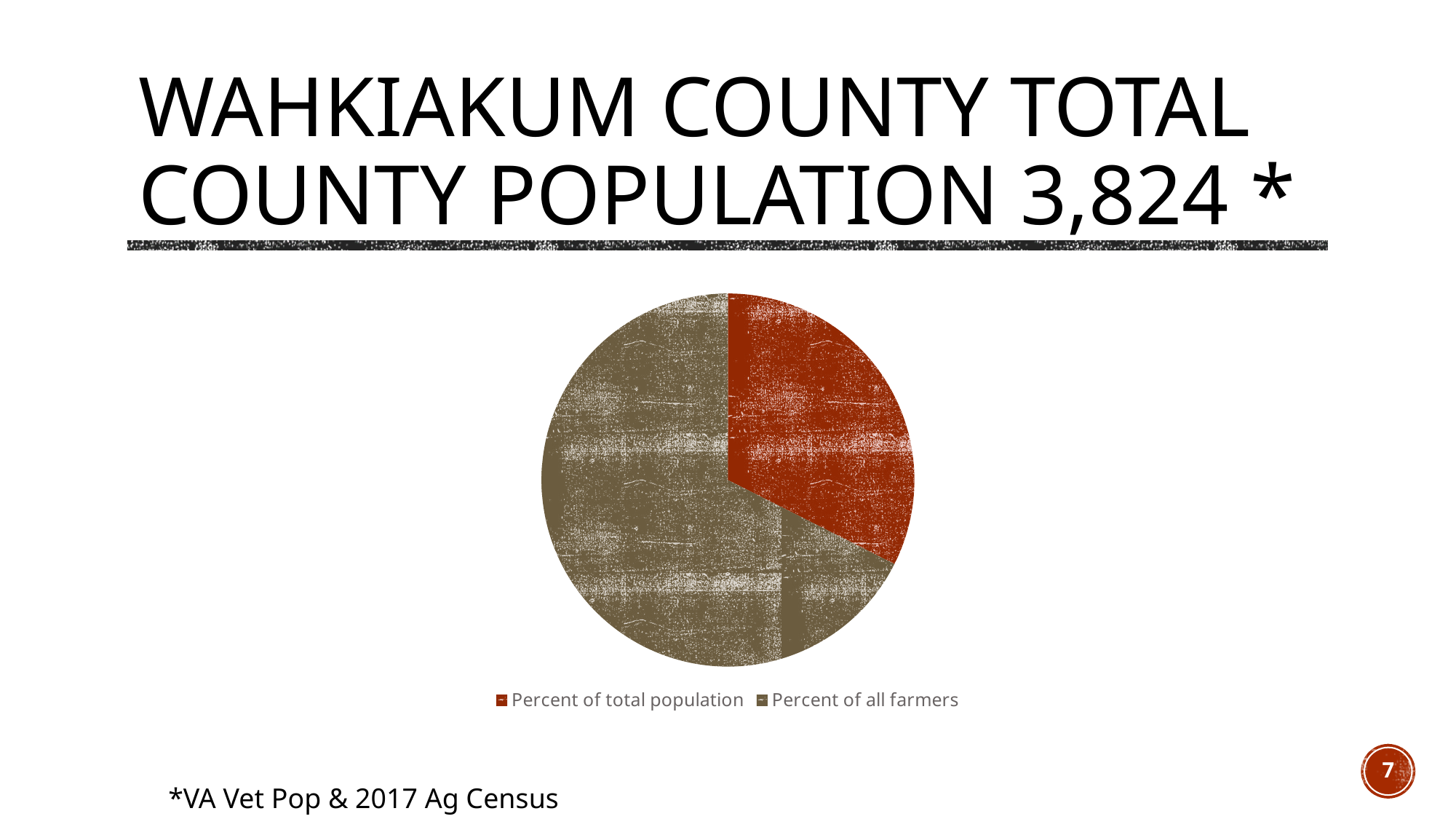
Which slice is larger in the pie chart: Percent of total population or Percent of all farmers? Percent of all farmers What colour is the Percent of total population slice in the pie chart? Red Does the Percent of all farmers slice take up more or less than half of the pie chart? More Which slice of the pie chart is the smallest? Percent of total population How many entries does the legend of the pie chart list? 2 How many slices does the pie chart have? 2 Which slice of the pie chart is the largest? Percent of all farmers What are the two legend entries of the pie chart? Percent of total population; Percent of all farmers What kind of chart is shown on the slide? Pie chart